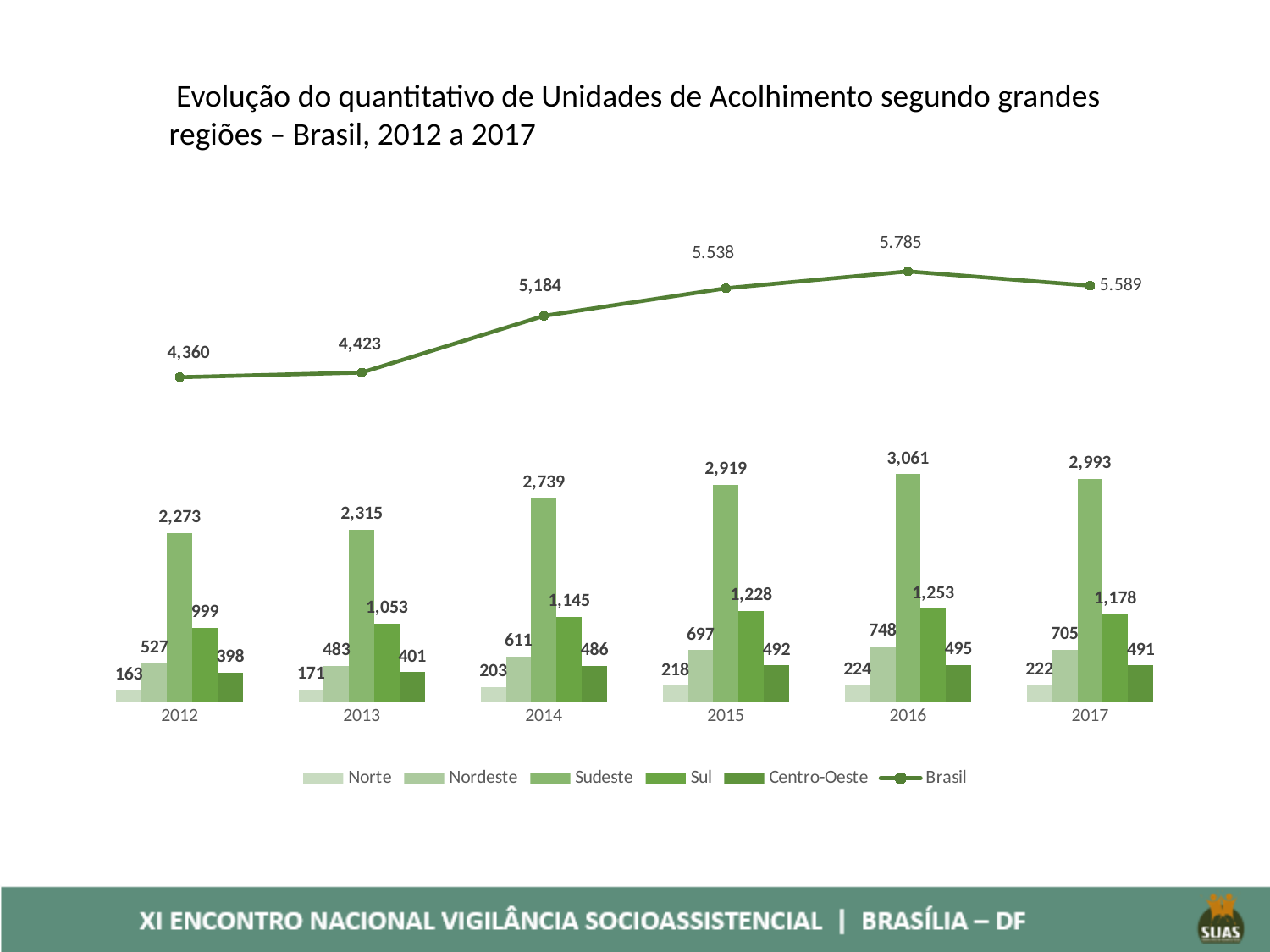
What is the value for Centro-Oeste in 2017? 491 Which is larger, Nordeste in 2016 or Nordeste in 2017? Nordeste in 2016 In which year is the Brasil line at its highest? 2016 How many years are shown on the x axis? 6 Does the Sudeste series rise or fall from 2012 to 2016? Rise How many series does the legend list? 6 Which region has the lowest value in 2015? Norte What is the difference between the Sul values in 2013 and 2012? 54 What is the value for Norte in 2012? 163 What is the value for Sudeste in 2016? 3,061 What is the Brasil line value for 2014? 5,184 What kind of chart is this? Combined bar and line chart